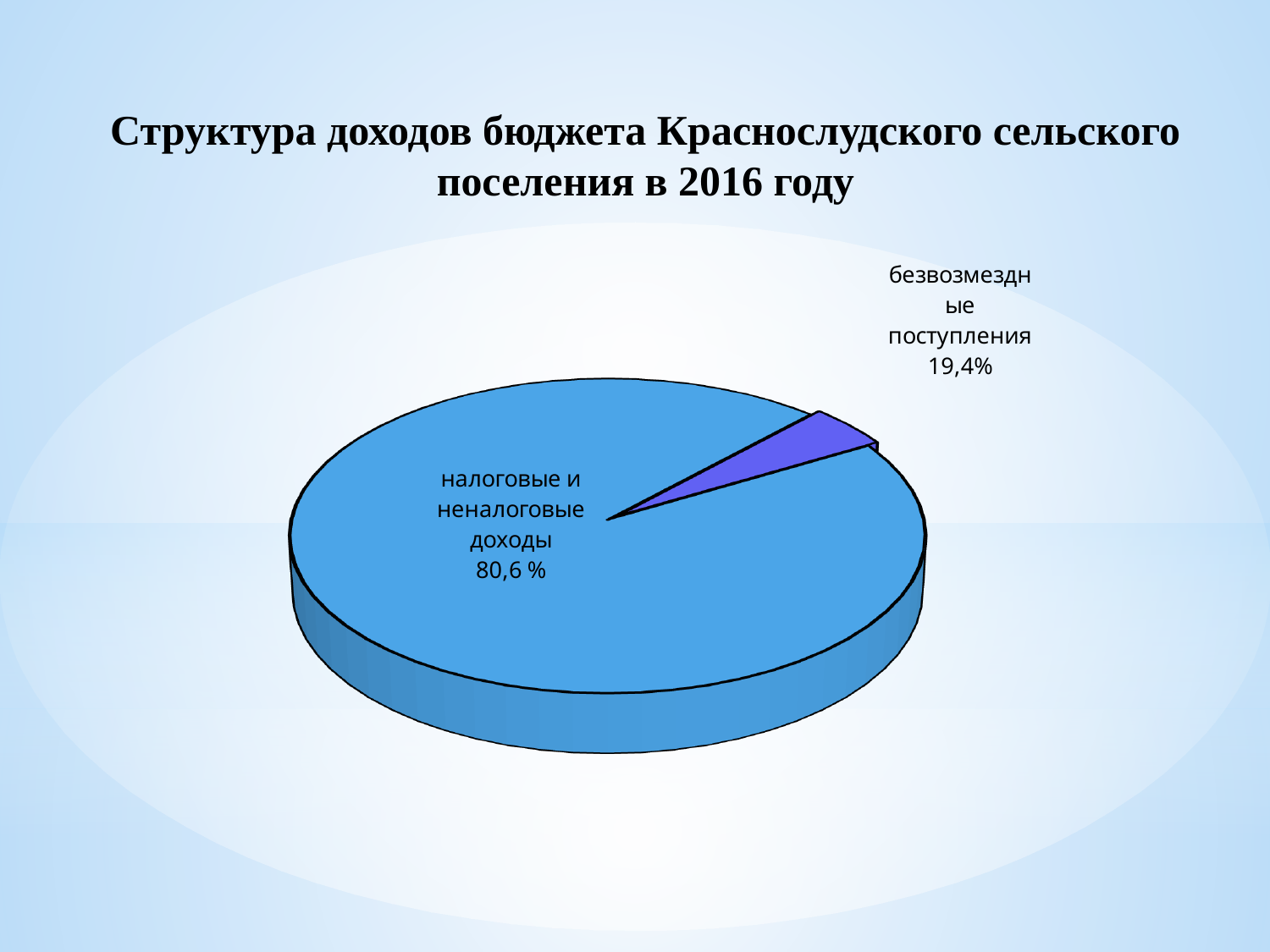
What kind of chart is shown on the slide? pie chart What colour is the slice for безвозмездные поступления? purple Which category has the smallest slice of the pie? безвозмездные поступления Is the share for безвозмездные поступления greater or less than 50%? less What share of the pie is labelled for безвозмездные поступления? 19,4% Which category has the largest slice of the pie? налоговые и неналоговые доходы What share of the pie is labelled for налоговые и неналоговые доходы? 80,6 % How many categories (slices) does the pie chart show? 2 Is the share for налоговые и неналоговые доходы greater or less than 50%? greater By how many percentage points does налоговые и неналоговые доходы exceed безвозмездные поступления? 61,2 What is the title of the chart on the slide? Структура доходов бюджета Краснослудского сельского поселения в 2016 году Which is larger: налоговые и неналоговые доходы or безвозмездные поступления? налоговые и неналоговые доходы